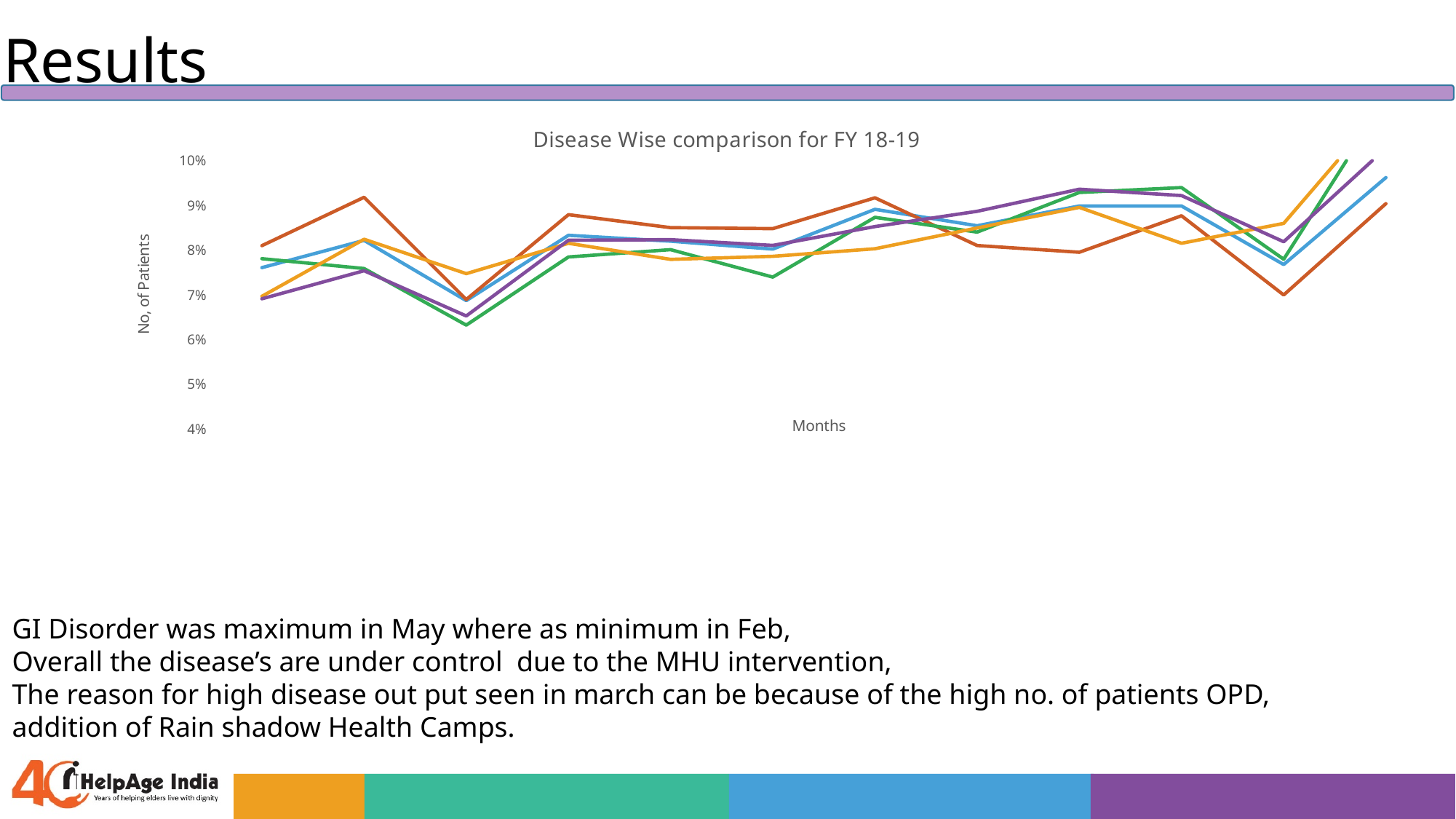
What is the lowest value shown on the vertical axis of the chart? 4% How many data points does each line on the chart have? 12 How many lines are plotted on the chart? 5 What is the title of the chart? Disease Wise comparison for FY 18-19 Is the highest point of the purple line greater or less than 9%? greater Does any line on the chart drop below 6%? no What kind of chart is shown on the slide? line chart What is the label on the vertical axis of the chart? No, of Patients